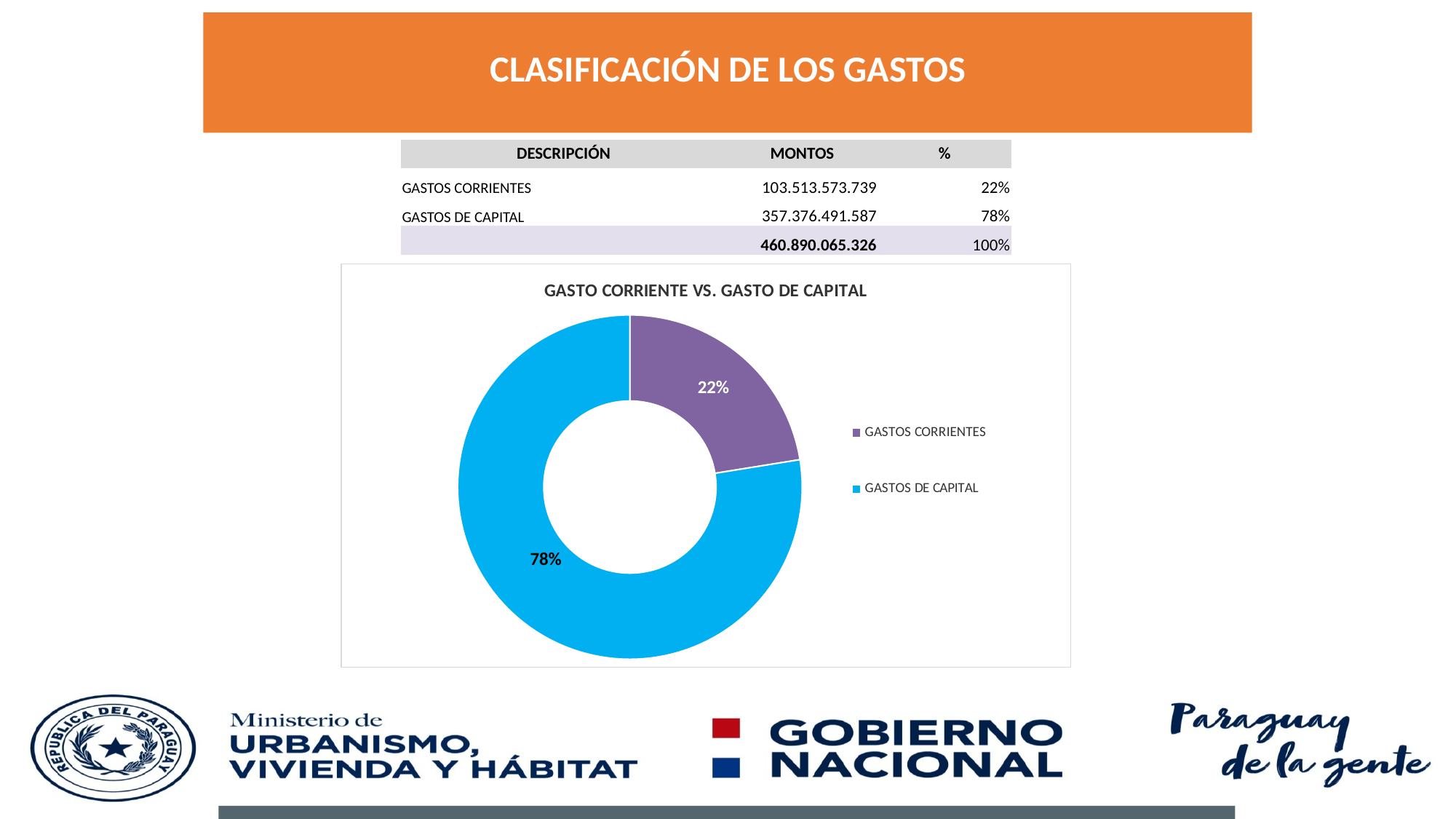
What colour represents GASTOS DE CAPITAL in the chart? Blue What share of the chart does GASTOS CORRIENTES represent? 22% What is the title of the chart? GASTO CORRIENTE VS. GASTO DE CAPITAL What type of chart is shown on the slide? Doughnut chart Is the share for GASTOS CORRIENTES greater or less than 50%? less Which category has the smallest share in the chart? GASTOS CORRIENTES What is the difference in percentage points between GASTOS DE CAPITAL and GASTOS CORRIENTES in the chart? 56 percentage points How many categories does the chart show? 2 What share of the chart does GASTOS DE CAPITAL represent? 78% Which is larger in the chart, GASTOS CORRIENTES or GASTOS DE CAPITAL? GASTOS DE CAPITAL How many entries does the chart legend list? 2 Which category has the largest share in the chart? GASTOS DE CAPITAL